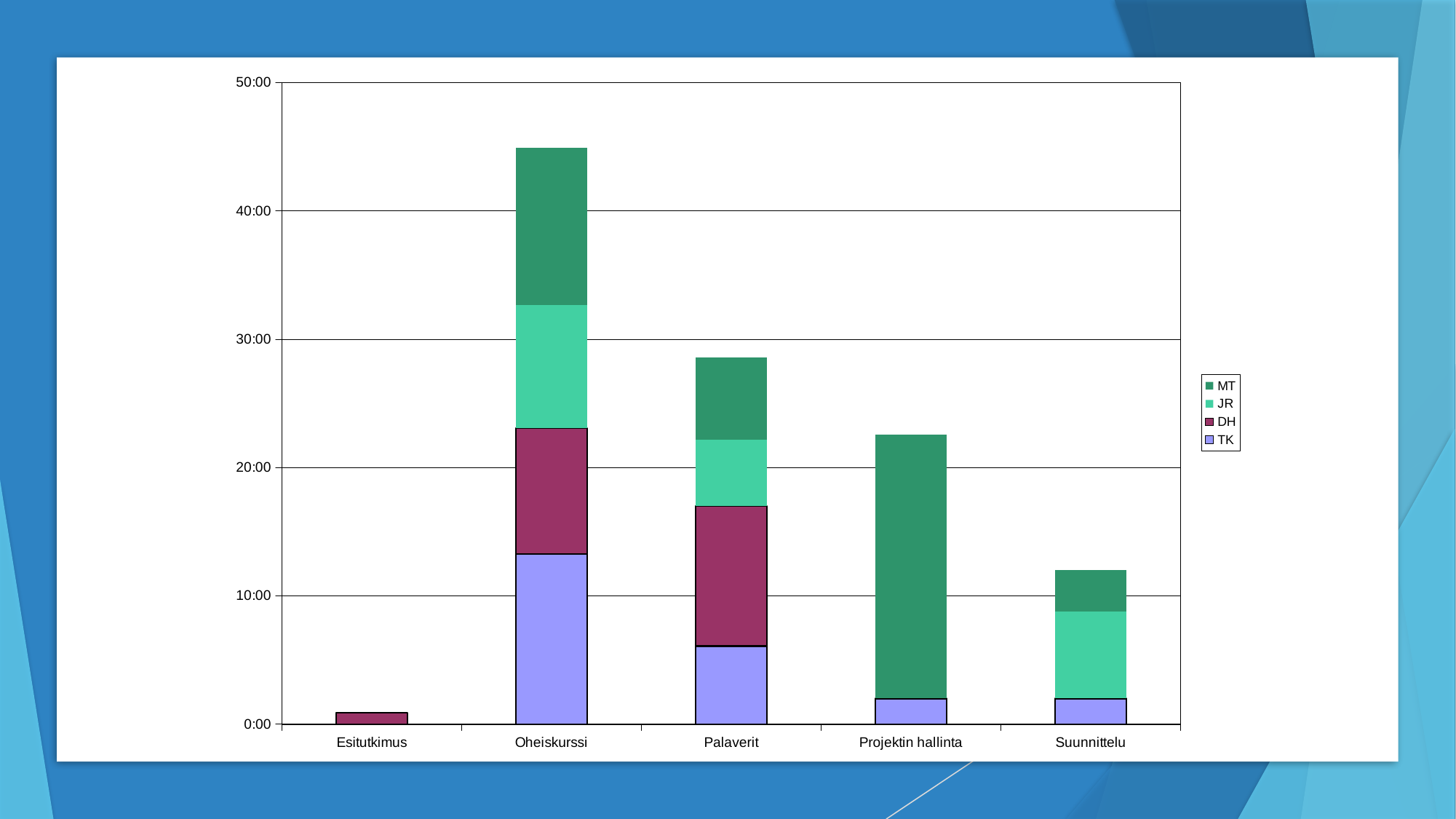
Which series is the only one present in the Esitutkimus bar? DH Is the total for Esitutkimus greater or less than 10:00? less Which category has the shortest stacked bar? Esitutkimus What kind of chart is shown on the slide? stacked bar chart Which series appears at the bottom of the stacked bars? TK How many series does the legend list? 4 How many categories are shown on the x axis? 5 Is the total for Oheiskurssi greater or less than 40:00? greater Which category has the tallest stacked bar? Oheiskurssi Is the total for Projektin hallinta greater or less than 20:00? greater Which has the larger total, Palaverit or Projektin hallinta? Palaverit